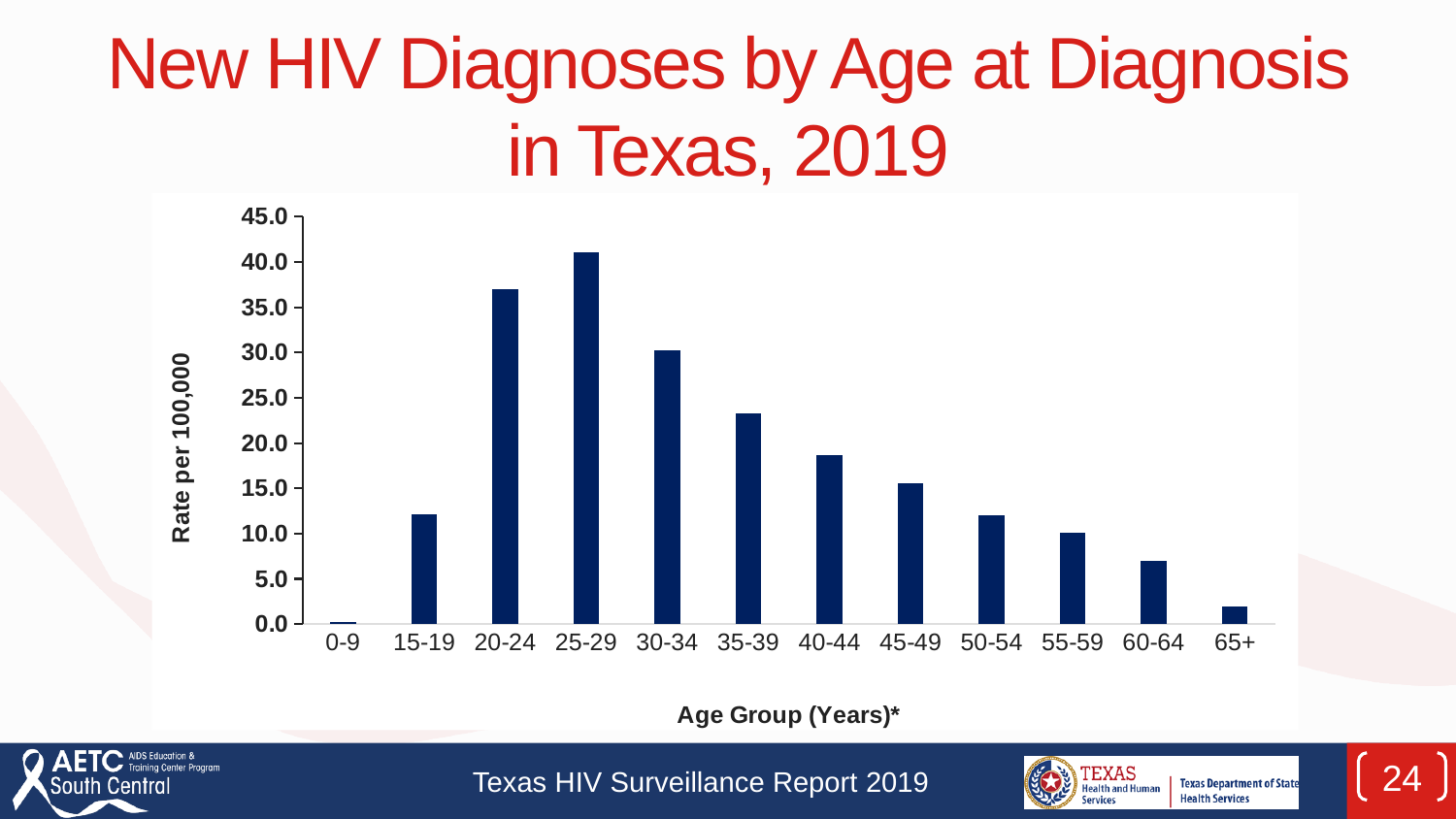
Is the rate for the 15-19 age group greater or less than 10.0? greater Which age group has the lowest rate per 100,000? 0-9 Which age group has a higher rate, 40-44 or 50-54? 40-44 Which age group has the highest rate per 100,000? 25-29 How many age groups are shown on the x axis? 12 What kind of chart is shown on the slide? bar chart Is the rate for the 35-39 age group greater or less than 25.0? less What is the label of the y axis? Rate per 100,000 Do the rates rise or fall across the age groups from 25-29 to 65+? fall Which age group has a higher rate, 20-24 or 30-34? 20-24 Is the rate for the 20-24 age group greater or less than 35.0? greater